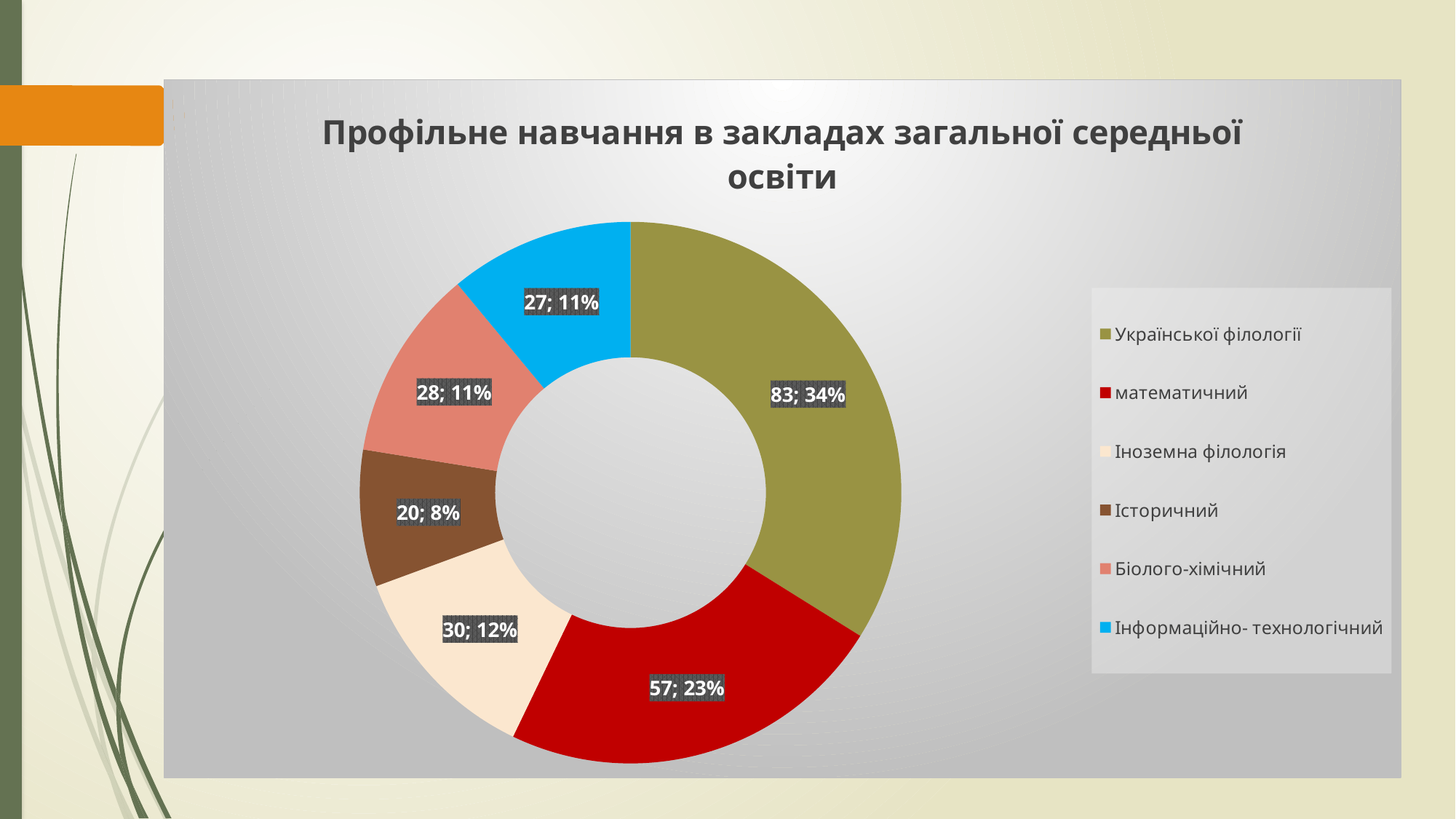
What percentage share does the Історичний slice have? 8% What is the value for Української філології? 83 What percentage share does the математичний slice have? 23% What is the value for Іноземна філологія? 30 What kind of chart is shown on the slide? doughnut chart Which is larger, the value for Біолого-хімічний or the value for Інформаційно- технологічний? Біолого-хімічний What is the title of the chart? Профільне навчання в закладах загальної середньої освіти How many categories are shown in the chart? 6 What is the difference between the values for Української філології and математичний? 26 Which category has the largest slice? Української філології What is the total of all the values shown in the chart? 245 Which category has the smallest slice? Історичний